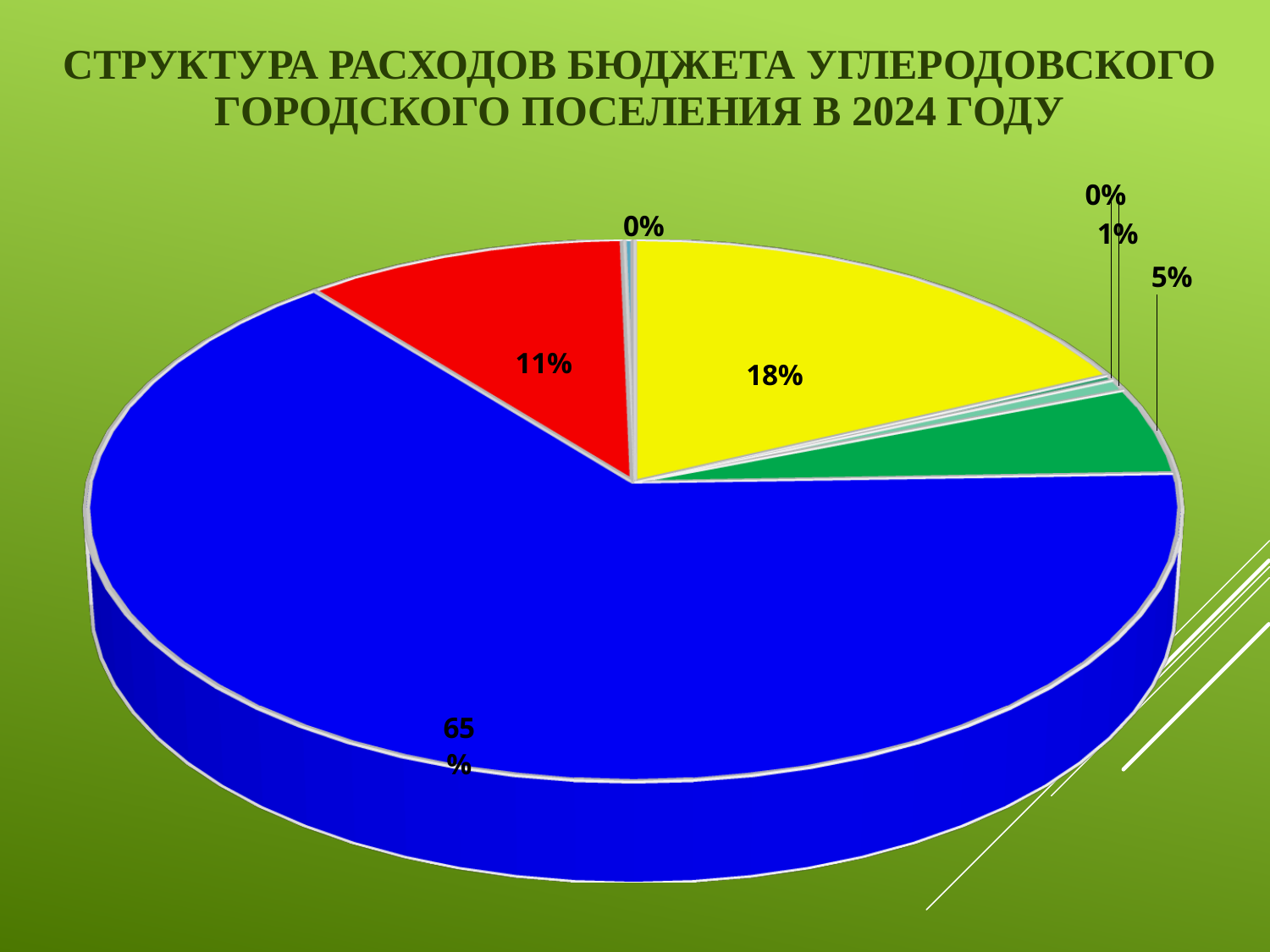
What is the difference in percentage points between the blue slice (65%) and the yellow slice (18%)? 47 Which is larger, the yellow slice or the red slice? yellow Which colour slice has the largest share of the pie? blue What kind of chart is shown on the slide? pie chart What percentage is shown for the blue slice of the pie? 65% What share of the pie does the largest slice take? 65% How many percentage labels are shown on the pie chart? 7 What percentage is shown for the red slice of the pie? 11% What is the title of the chart on the slide? СТРУКТУРА РАСХОДОВ БЮДЖЕТА УГЛЕРОДОВСКОГО ГОРОДСКОГО ПОСЕЛЕНИЯ В 2024 ГОДУ What is the difference in percentage points between the yellow slice (18%) and the red slice (11%)? 7 What percentage is shown for the yellow slice of the pie? 18% What percentage is shown for the green slice of the pie? 5%